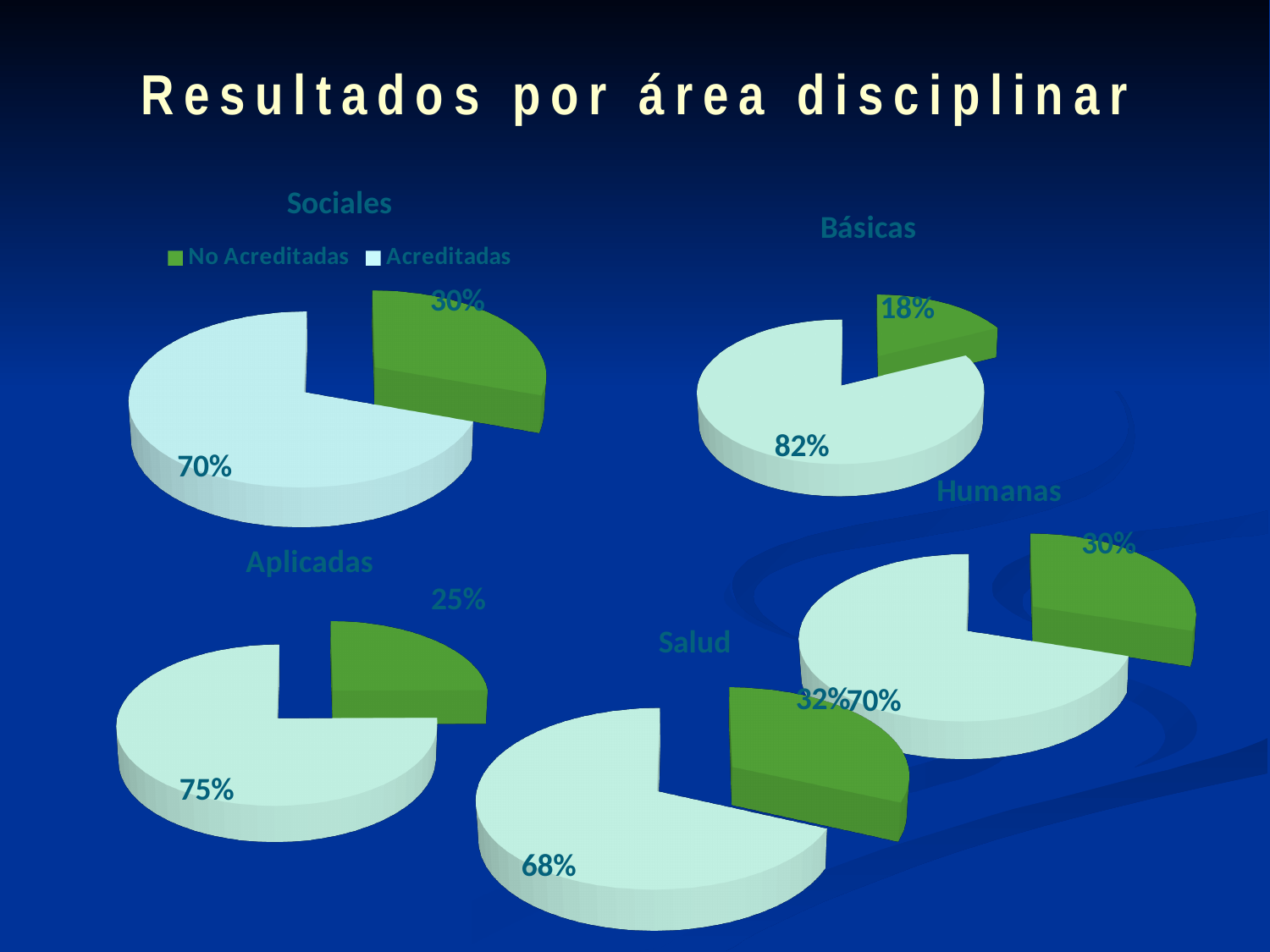
In the "Humanas" pie chart, what share is labelled for Acreditadas? 70% What is the difference between the Acreditadas share in the "Básicas" chart and the Acreditadas share in the "Salud" chart? 14% How many entries does the legend of the "Sociales" chart list? 2 In the "Sociales" pie chart, what share is labelled for Acreditadas? 70% In the "Salud" pie chart, what share is labelled for No Acreditadas? 32% In the "Básicas" pie chart, what share is labelled for Acreditadas? 82% In the "Sociales" pie chart, what share is labelled for No Acreditadas? 30% How many pie charts are shown on the slide? 5 Across the five pie charts, which area has the lowest Acreditadas share? Salud In the "Aplicadas" pie chart, what share is labelled for Acreditadas? 75% In the "Básicas" pie chart, what share is labelled for No Acreditadas? 18% Across the five pie charts, which area has the highest Acreditadas share? Básicas